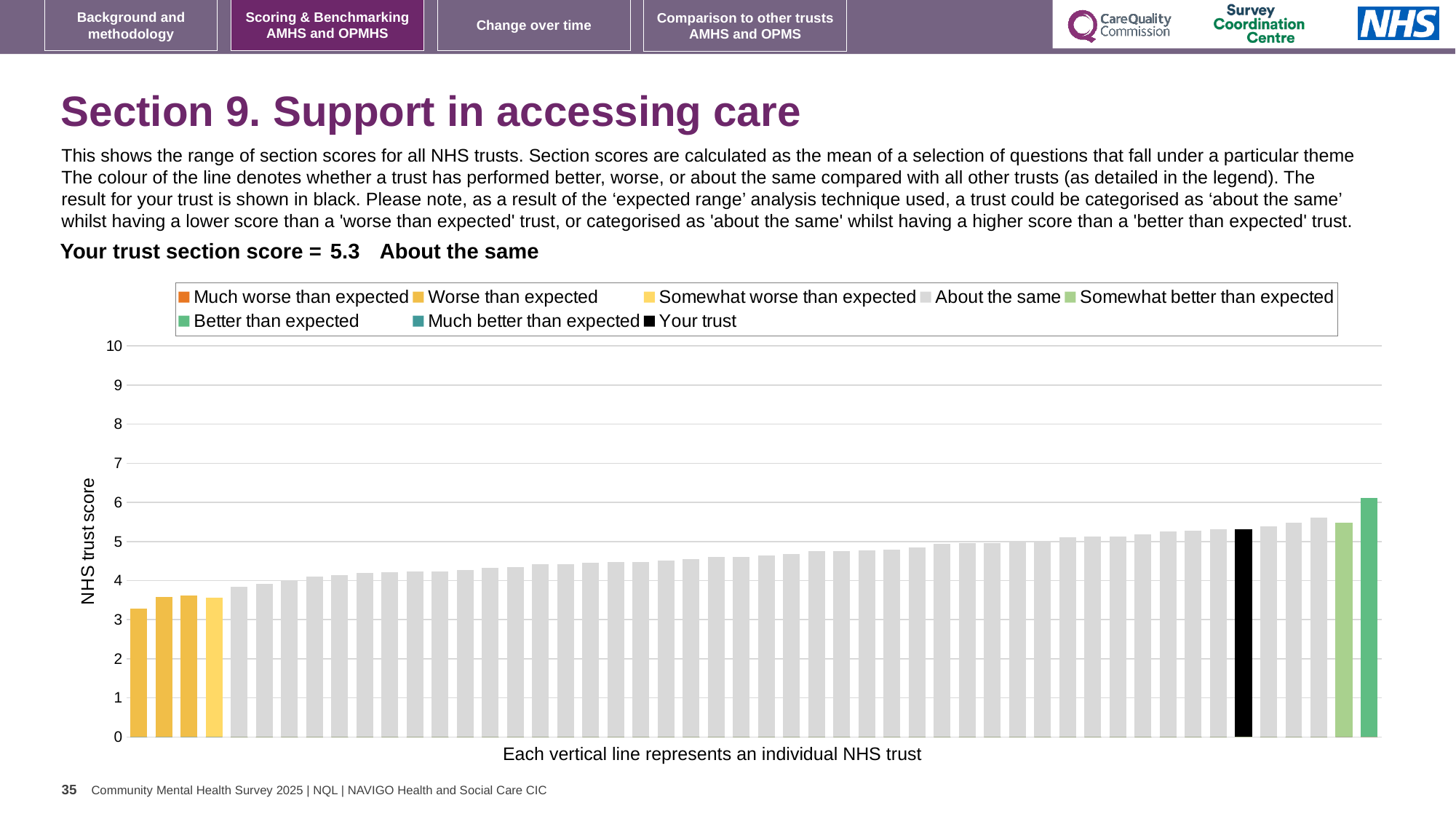
Which legend category does the highest bar in the chart belong to? Better than expected Is the value for the black 'Your trust' bar greater or less than 5? greater Which is larger, the black 'Your trust' bar or the leftmost bar? the black 'Your trust' bar How many entries does the chart legend list? 8 Is the value of the highest bar in the chart greater or less than 5? greater Is the value of the lowest bar in the chart greater or less than 4? less What kind of chart is shown on the slide? bar chart Which category is your trust placed in according to the text above the chart? About the same What is the label on the vertical axis of the chart? NHS trust score Do the bar values rise or fall moving from left to right along the x axis? rise What is the section score for your trust shown on the slide? 5.3